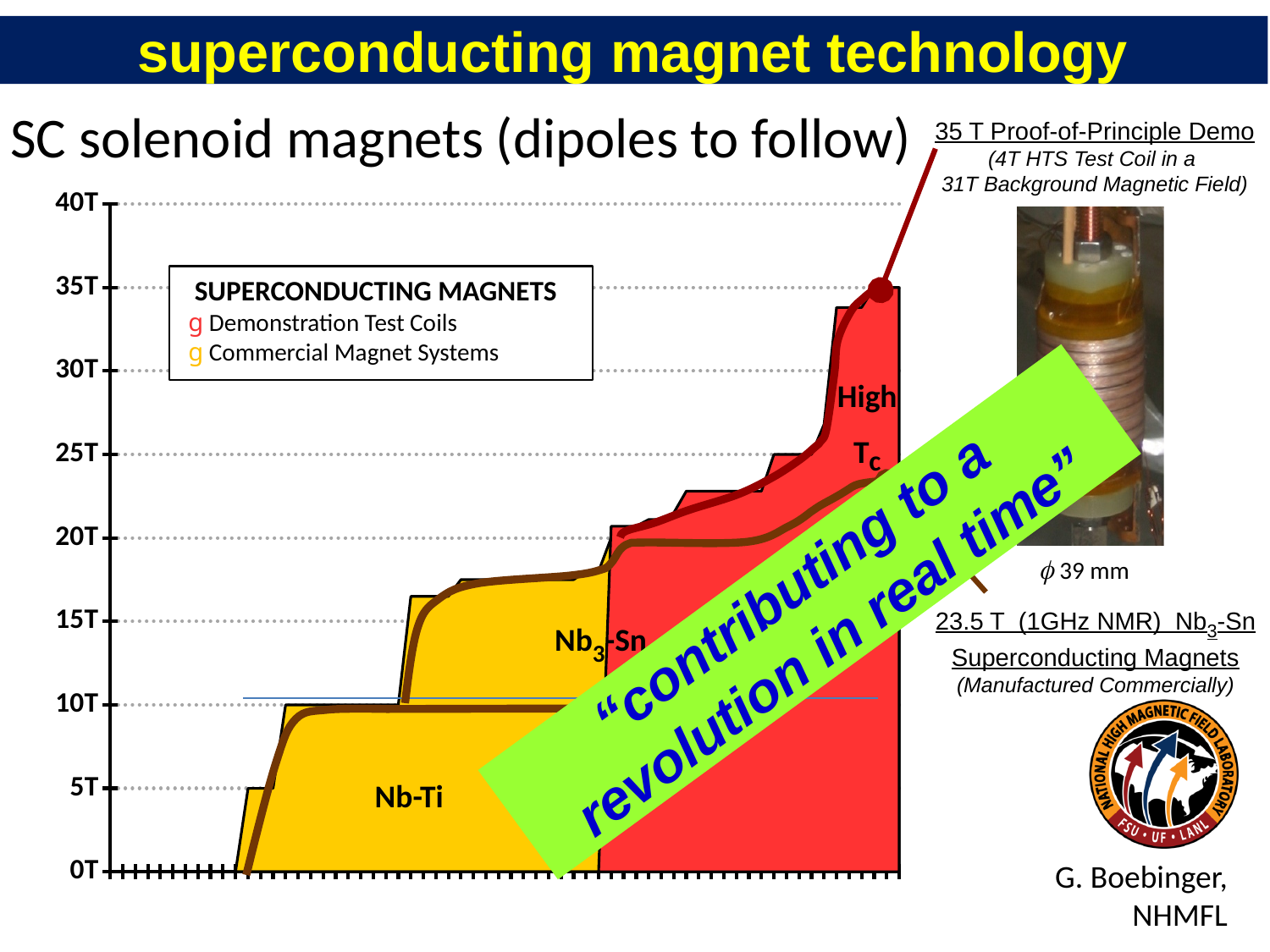
Which labelled material region reaches the highest magnetic field on the chart? High Tc How many superconducting material regions are labelled on the chart? 3 What is the highest value shown on the chart's vertical axis? 40T Is the peak value of the High Tc region greater or less than 30T? greater What field value is annotated for the commercially manufactured Nb3-Sn (1GHz NMR) superconducting magnets? 23.5 T Which labelled material region has the lowest magnetic field plateau on the chart? Nb-Ti How many series does the chart legend list? 2 What field value is annotated for the Proof-of-Principle Demo at the top of the chart? 35 T Do the magnetic field values rise or fall moving left to right along the x axis? rise Is the plateau value for the Nb3-Sn region greater or less than 15T? greater What kind of chart is shown on the slide? area chart What are the two series named in the chart legend? Demonstration Test Coils; Commercial Magnet Systems